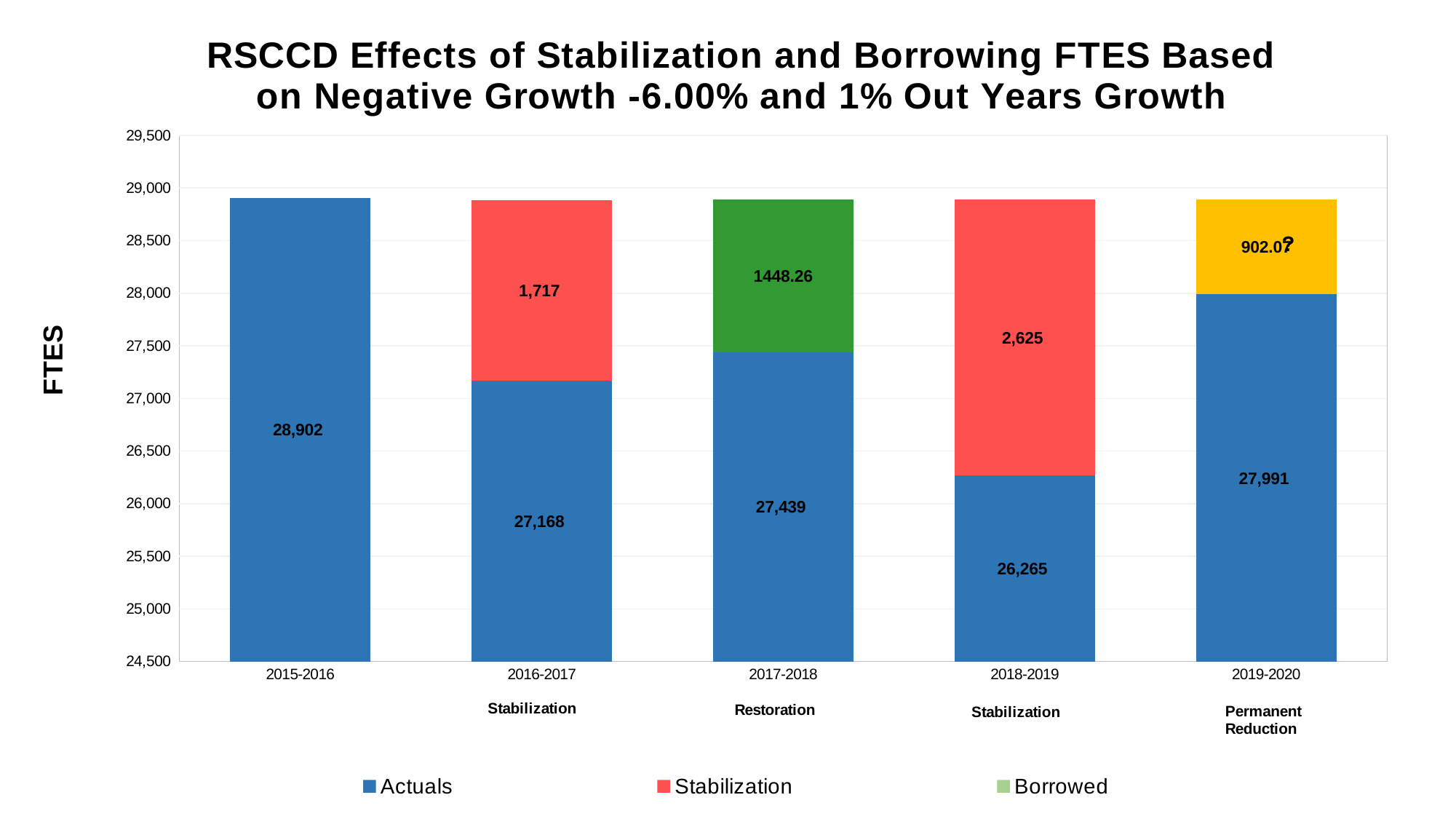
What kind of chart is shown on the slide? Stacked bar chart Which year has the lowest Actuals value? 2018-2019 Which year has the highest Actuals value? 2015-2016 What is the Actuals value for 2015-2016? 28,902 What is the total of the stacked bar for 2018-2019? 28,890 What is the difference between the Actuals values for 2015-2016 and 2018-2019? 2,637 How many years are shown on the x axis? 5 What is the Actuals value for 2019-2020? 27,991 Which is larger, the Stabilization value for 2016-2017 or for 2018-2019? 2018-2019 How many series does the legend list? 3 What is the Borrowed value for 2017-2018? 1448.26 What is the Stabilization value for 2018-2019? 2,625